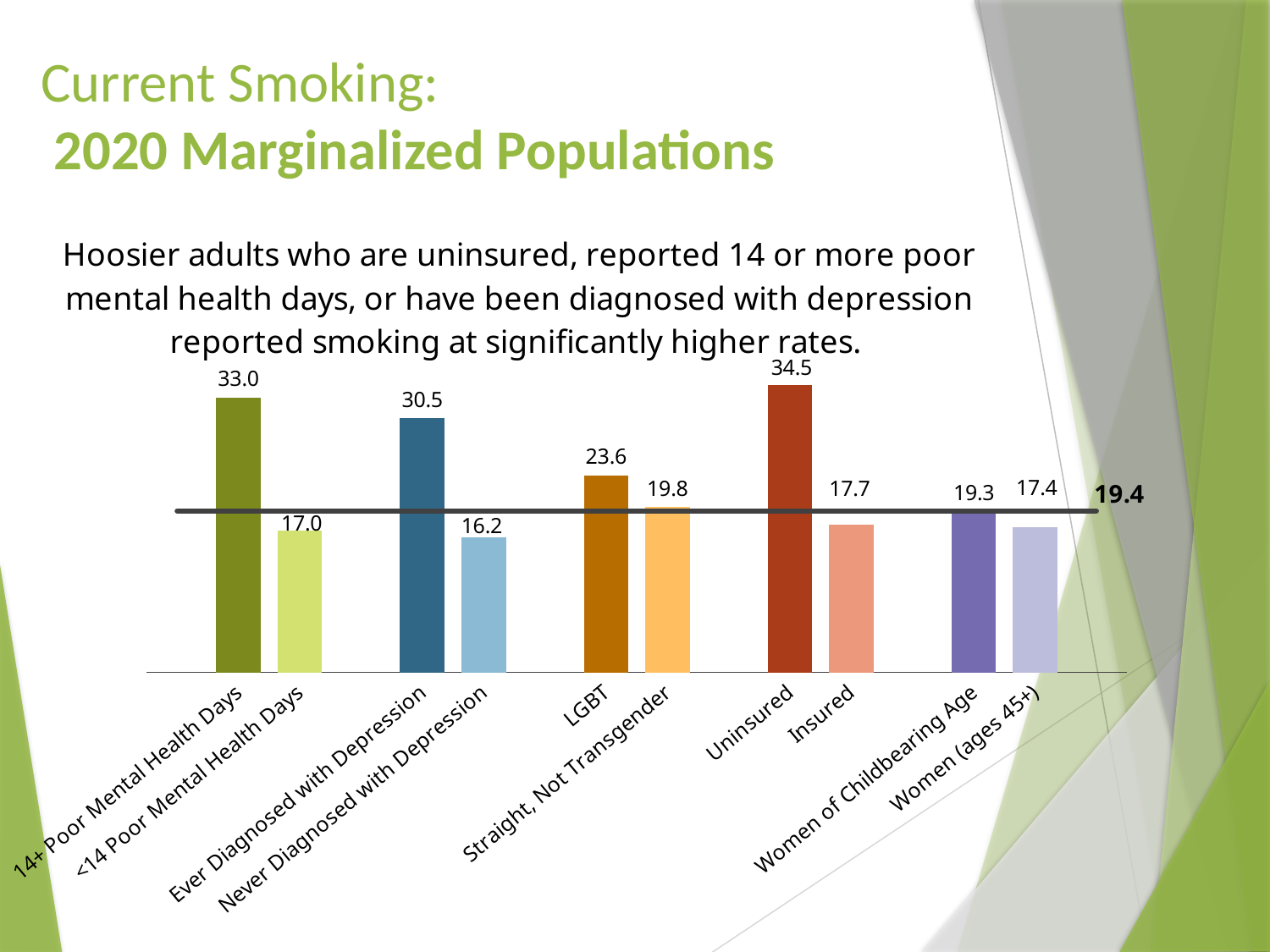
What is the difference between the values for Uninsured and Insured? 16.8 What is the difference between the values for 14+ Poor Mental Health Days and <14 Poor Mental Health Days? 16.0 Which is larger, the value for LGBT or the value for Straight, Not Transgender? LGBT What value is labelled on the horizontal reference line across the chart? 19.4 What is the value for 14+ Poor Mental Health Days? 33.0 What is the value for Never Diagnosed with Depression? 16.2 What is the value for Uninsured? 34.5 How many categories are shown on the x axis? 10 Which category has the highest value? Uninsured What kind of chart is shown on the slide? Bar chart What is the value for LGBT? 23.6 Which category has the lowest value? Never Diagnosed with Depression